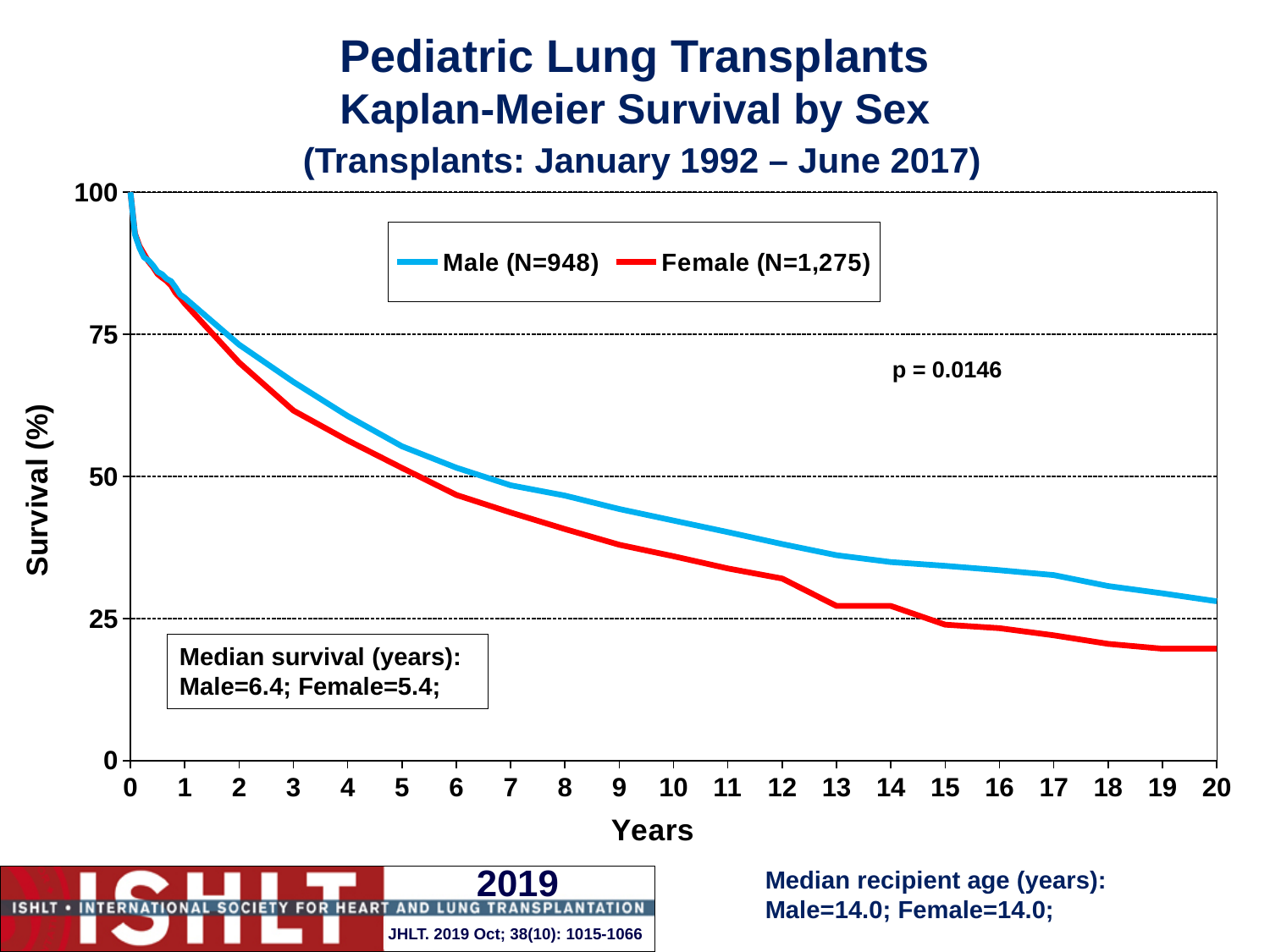
What kind of chart is shown on the slide? Line chart Do the survival curves rise or fall as years increase? Fall What is the N for the Female group shown in the legend? 1,275 What is the p-value shown on the chart? p = 0.0146 What is the median survival in years for females? 5.4 At 10 years, which group has the higher survival, Male or Female? Male What is the difference in median survival (years) between males and females? 1.0 Is the Male survival value at 20 years greater or less than 25? greater What is the N for the Male group shown in the legend? 948 Is the Female survival value at 20 years greater or less than 25? less What is the median survival in years for males? 6.4 How many series does the legend list? 2